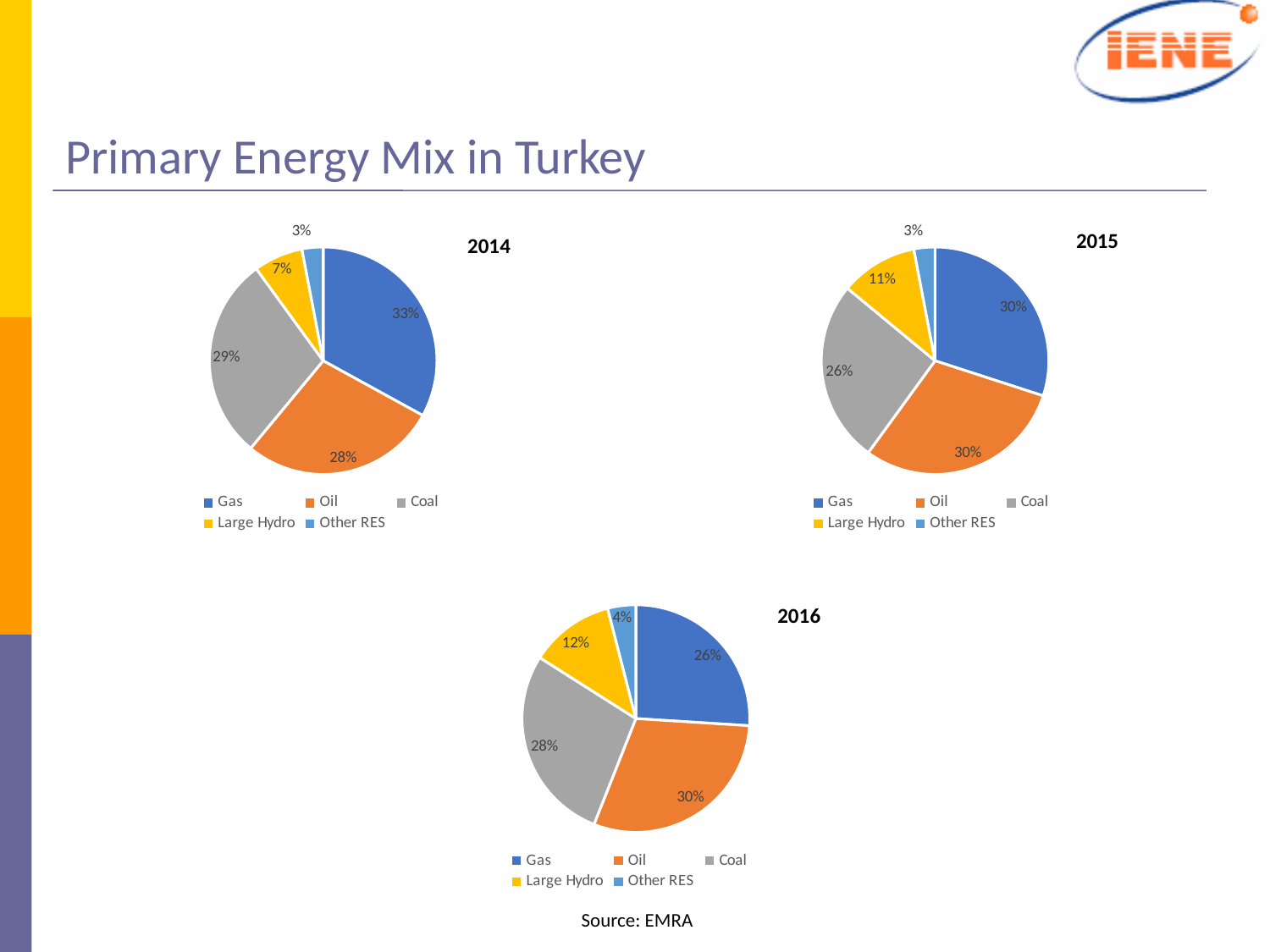
In the 2016 chart, which category has the largest share? Oil In the 2014 chart, what is the difference between the Coal share and the Large Hydro share? 22% In the 2016 chart, what share does Other RES have? 4% What colour represents Oil in the 2014 chart? Orange In the 2016 chart, which is larger, the Coal share or the Gas share? Coal In the 2016 chart, what is the combined share of Large Hydro and Other RES? 16% In the 2015 chart, what share does Large Hydro have? 11% What kind of chart is the 2016 chart? Pie chart In the 2015 chart, which category has the smallest share? Other RES In the 2014 chart, what share does Gas have? 33% How many categories does the 2015 chart's legend list? 5 In the 2014 chart, which category has the largest share? Gas